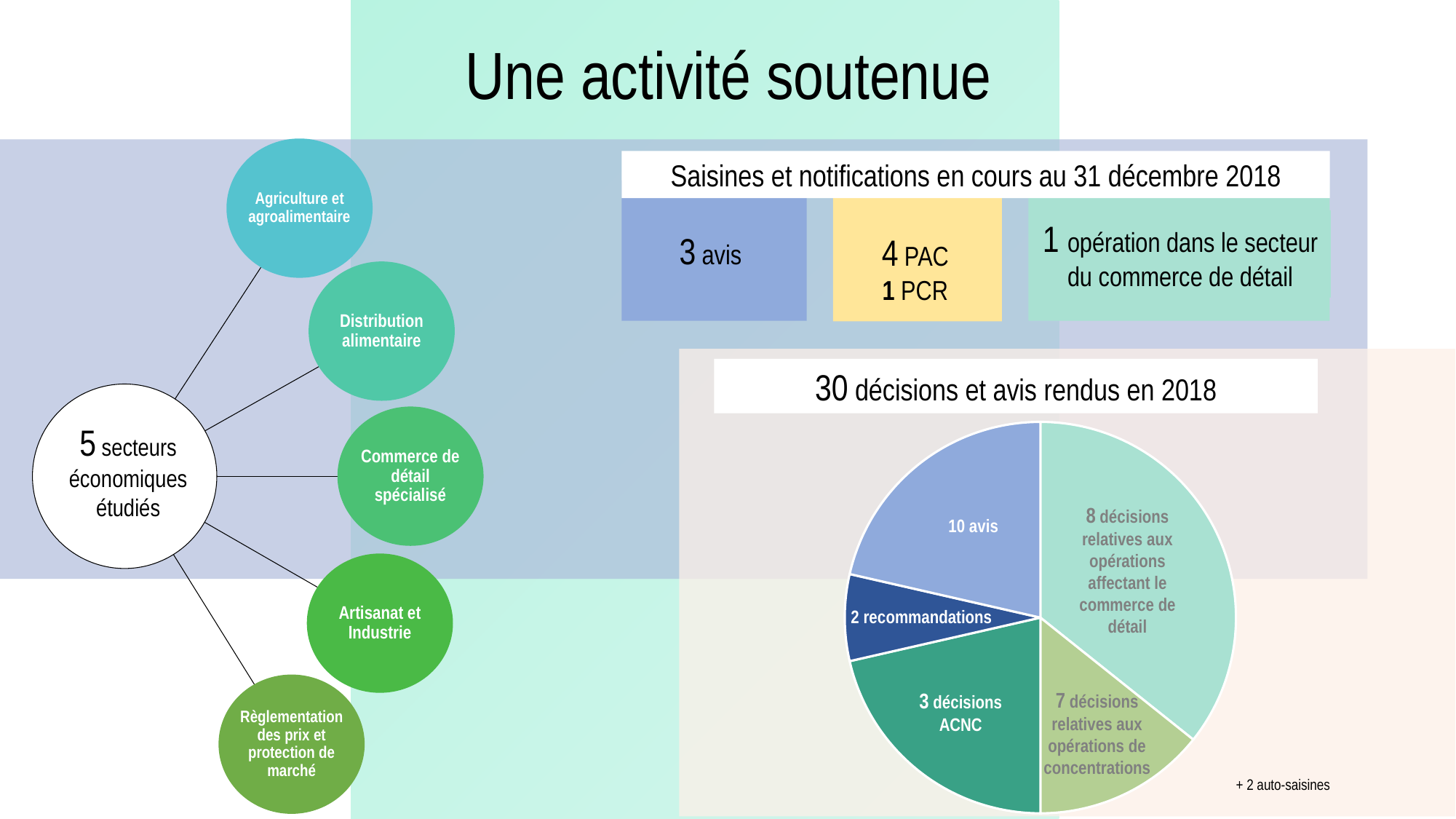
What is the total number of décisions et avis represented in the pie chart? 30 How many slices does the pie chart have? 5 What kind of chart is shown under the heading "30 décisions et avis rendus en 2018"? pie chart In the pie chart, how many recommandations are shown? 2 In the pie chart, how many "avis" are shown? 10 What is the difference between the number of avis and the number of décisions ACNC in the pie chart? 7 Which slice of the pie chart is the smallest? 2 recommandations In the pie chart, how many décisions relatives aux opérations de concentrations are shown? 7 Which is larger in the pie chart: décisions relatives aux opérations affectant le commerce de détail or décisions relatives aux opérations de concentrations? décisions relatives aux opérations affectant le commerce de détail In the pie chart, how many décisions relatives aux opérations affectant le commerce de détail are shown? 8 In the pie chart, how many décisions ACNC are shown? 3